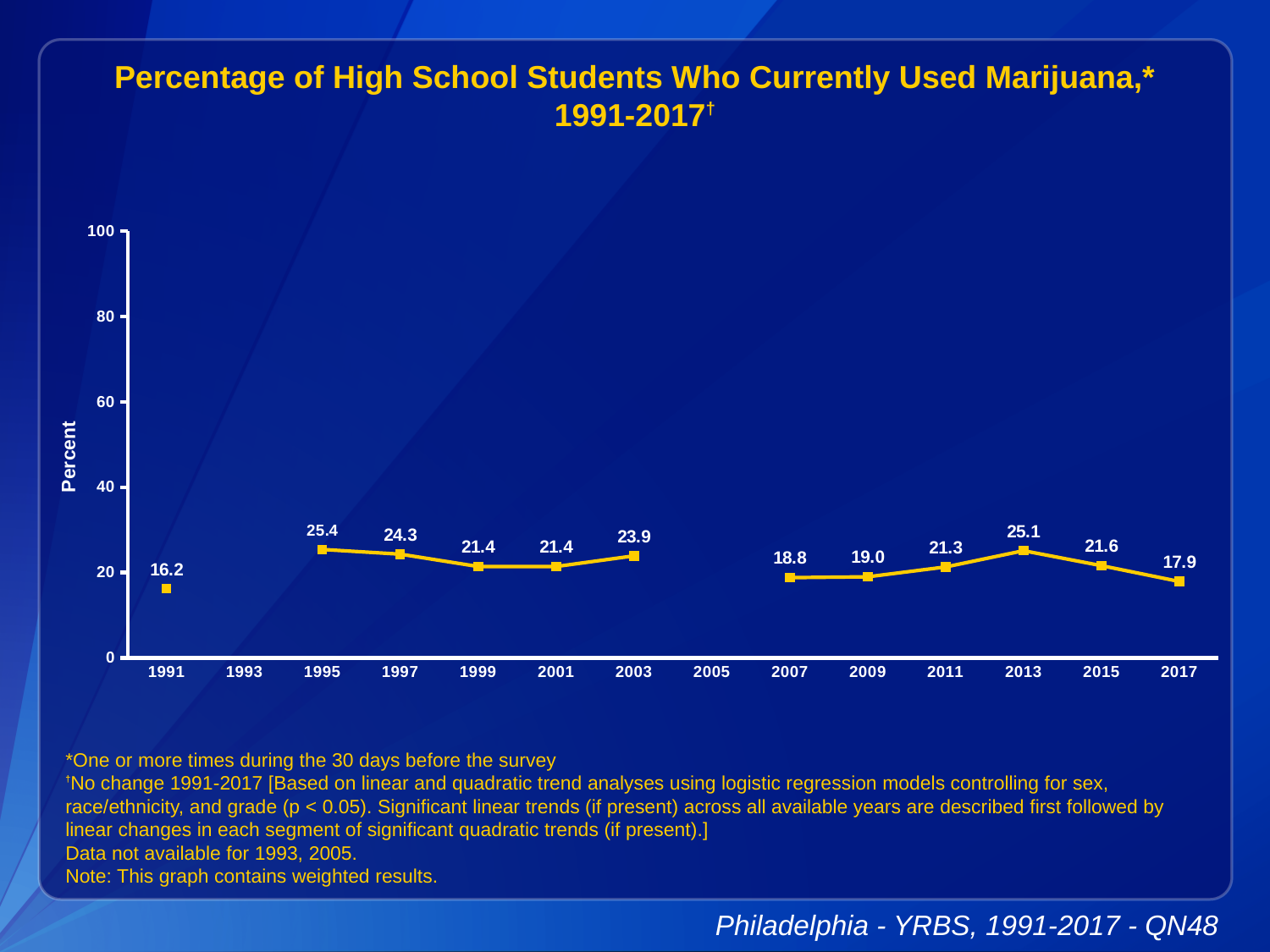
Which year has the highest percentage on the chart? 1995 What is the difference between the values for 2013 and 2017? 7.2 What is the label on the vertical axis? Percent How many years have data points plotted on the chart? 12 Which year has a larger value, 2007 or 2011? 2011 What kind of chart is shown on the slide? Line chart Which year has the lowest percentage on the chart? 1991 What is the difference between the values for 1995 and 1997? 1.1 What was the percentage of high school students who currently used marijuana in 1991? 16.2 What value is shown for 2013? 25.1 What value is shown for 2017? 17.9 Is the value for 2003 greater or less than 20? greater